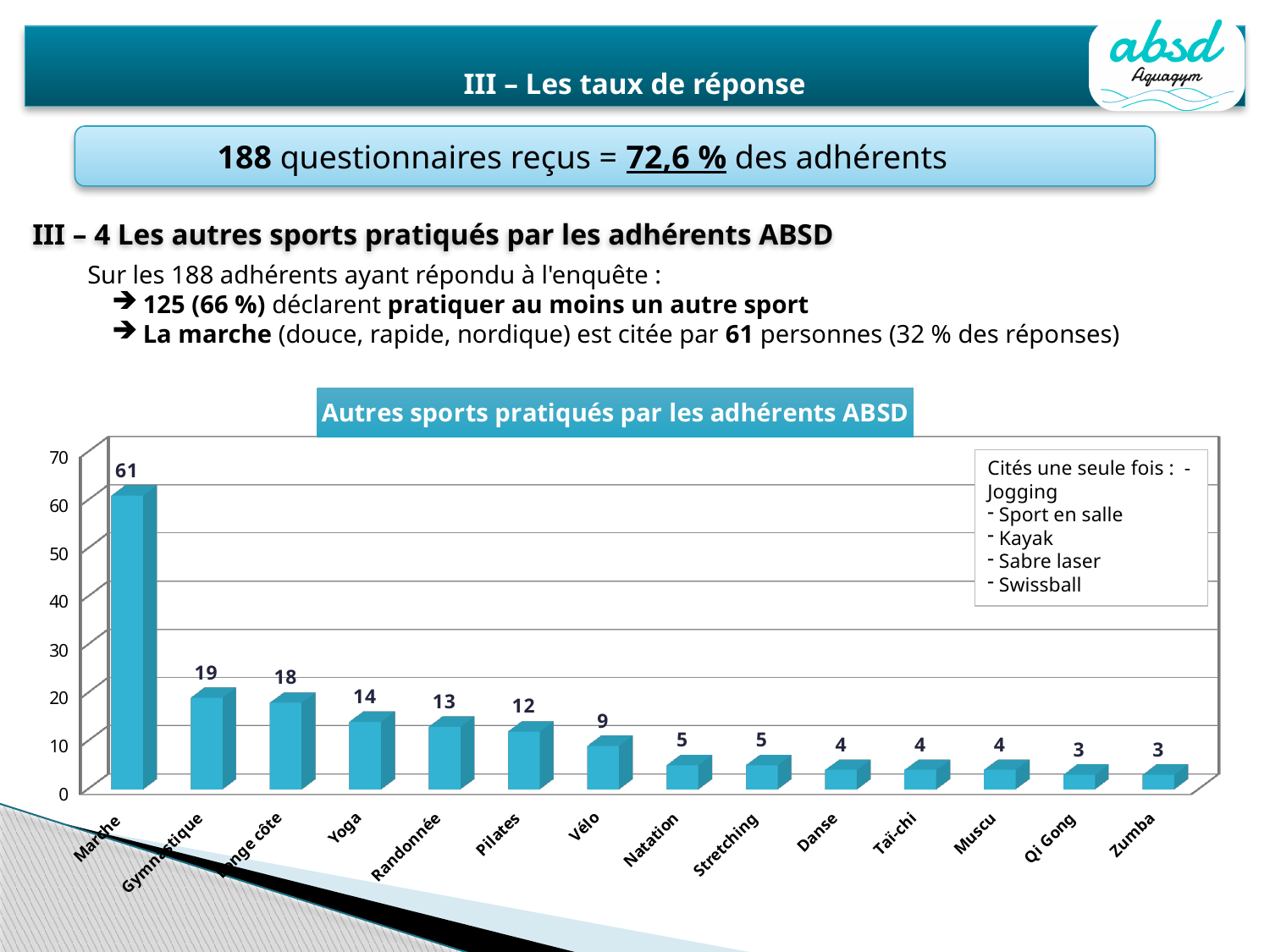
Which sport has the highest value in the chart? Marche What is the difference between the values for Marche and Gymnastique? 42 What is the value for Randonnée? 13 What is the value for Yoga? 14 What is the value for Pilates? 12 What is the title of the chart? Autres sports pratiqués par les adhérents ABSD What kind of chart is shown on the slide? Bar chart Which has a larger value, Vélo or Pilates? Pilates How many sports (categories) are shown in the chart? 14 Which has a larger value, Natation or Danse? Natation What is the difference between the values for Gymnastique and Yoga? 5 What is the value for Vélo? 9